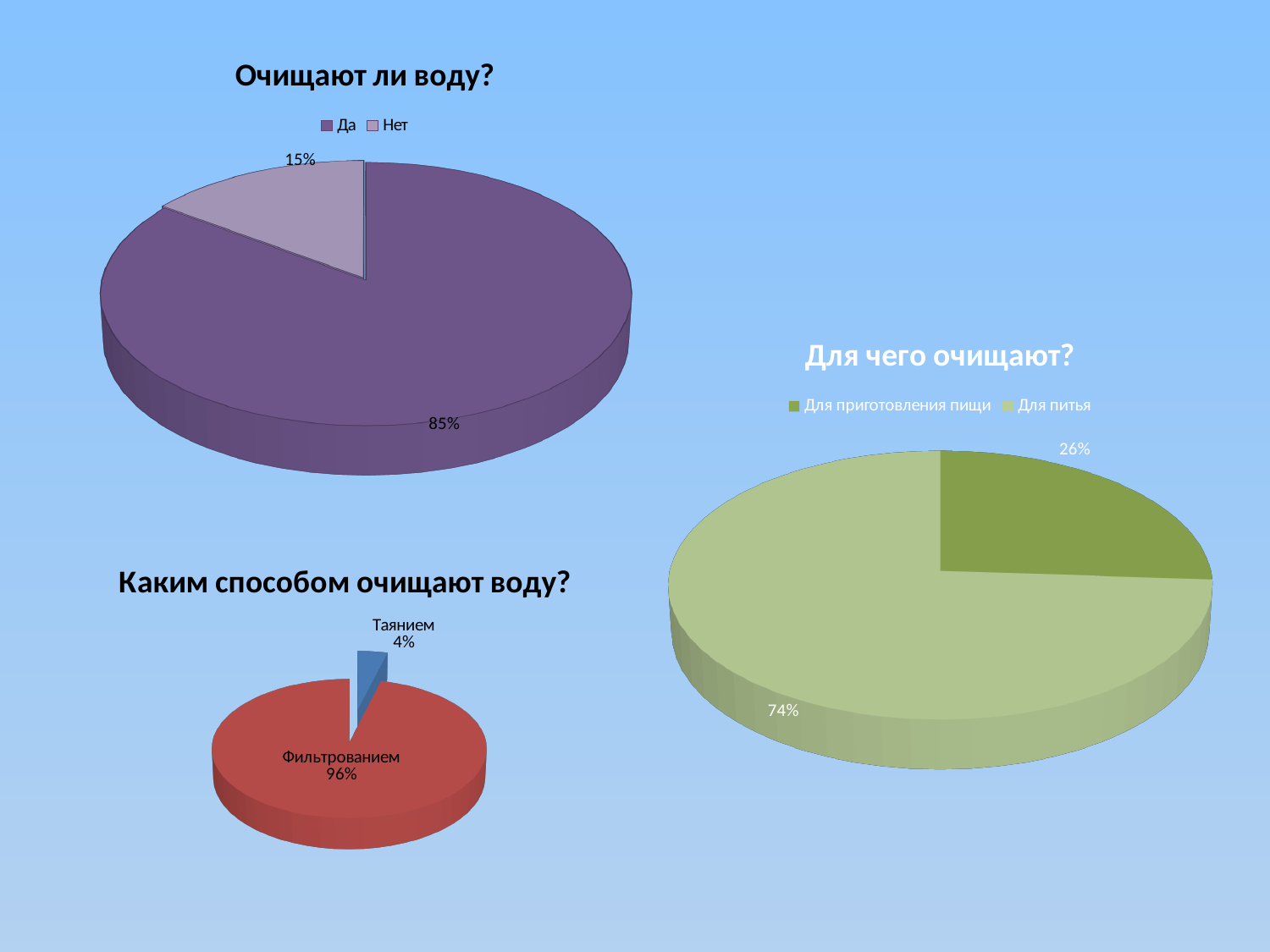
In the chart titled "Очищают ли воду?", which slice is the largest? Да In the chart titled "Очищают ли воду?", what is the difference between the "Да" and "Нет" shares? 70% In the chart titled "Для чего очищают?", what share of the pie is "Для приготовления пищи"? 26% In the chart titled "Каким способом очищают воду?", what share of the pie is "Фильтрованием"? 96% In the chart titled "Для чего очищают?", what share of the pie is "Для питья"? 74% In the chart titled "Каким способом очищают воду?", which is larger, "Фильтрованием" or "Таянием"? Фильтрованием What kind of chart is the chart titled "Очищают ли воду?"? Pie chart In the chart titled "Для чего очищают?", which slice is the smallest? Для приготовления пищи How many entries does the legend of the chart titled "Для чего очищают?" list? 2